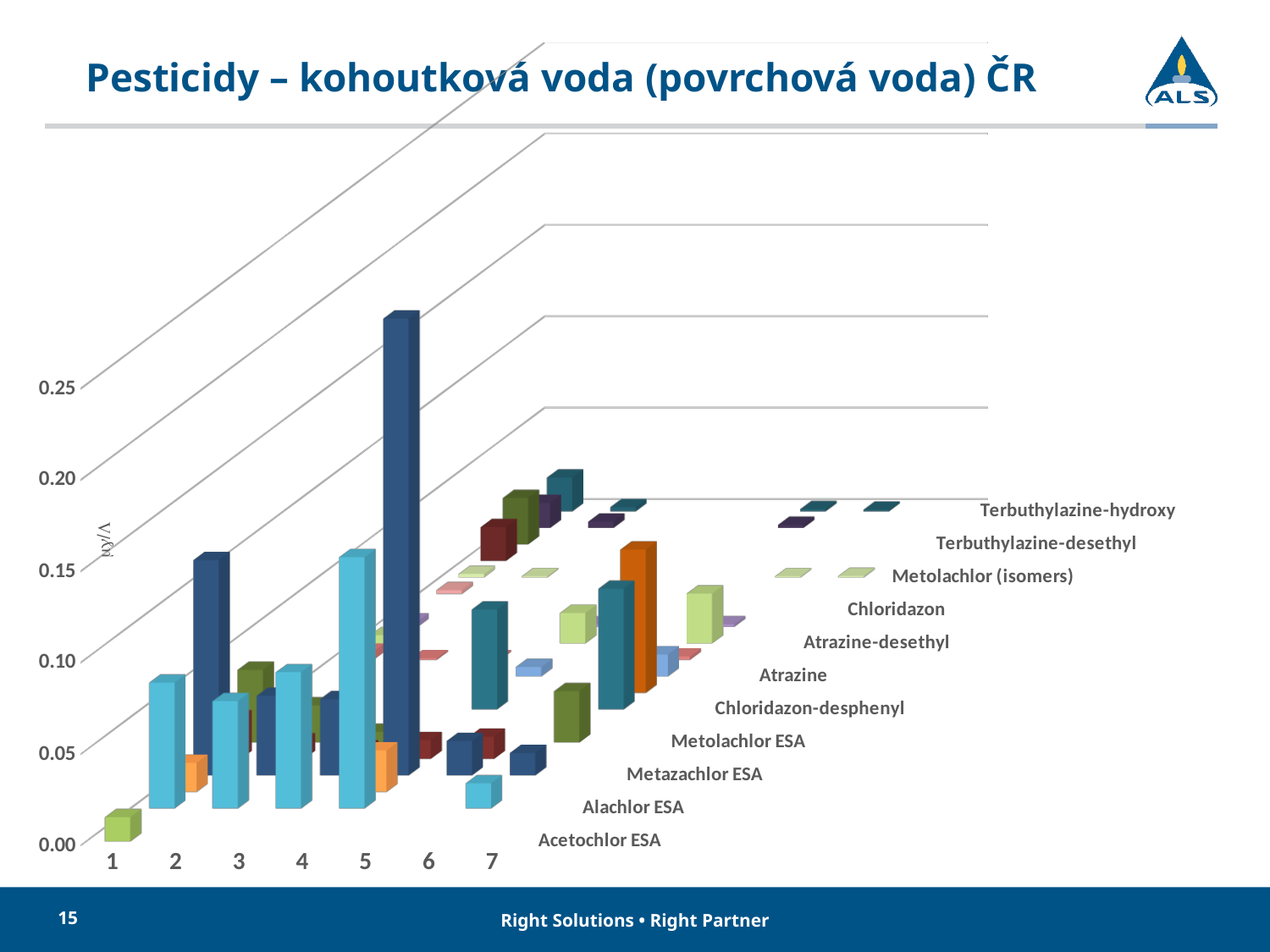
How many series (pesticide names) are listed along the depth axis of the chart? 11 Is the tallest bar in the chart (at category 5) greater or less than 0.15? greater What unit is shown on the vertical axis of the chart? µg/l Which numbered category contains the tallest bar in the chart? 4 What kind of chart is shown on the slide? bar chart Is the value for Acetochlor ESA at category 1 greater or less than 0.05? less What is the title of the slide containing the chart? Pesticidy – kohoutková voda (povrchová voda) ČR What is the highest value labelled on the vertical axis of the chart? 0.25 How many numbered categories are shown along the x axis of the chart? 7